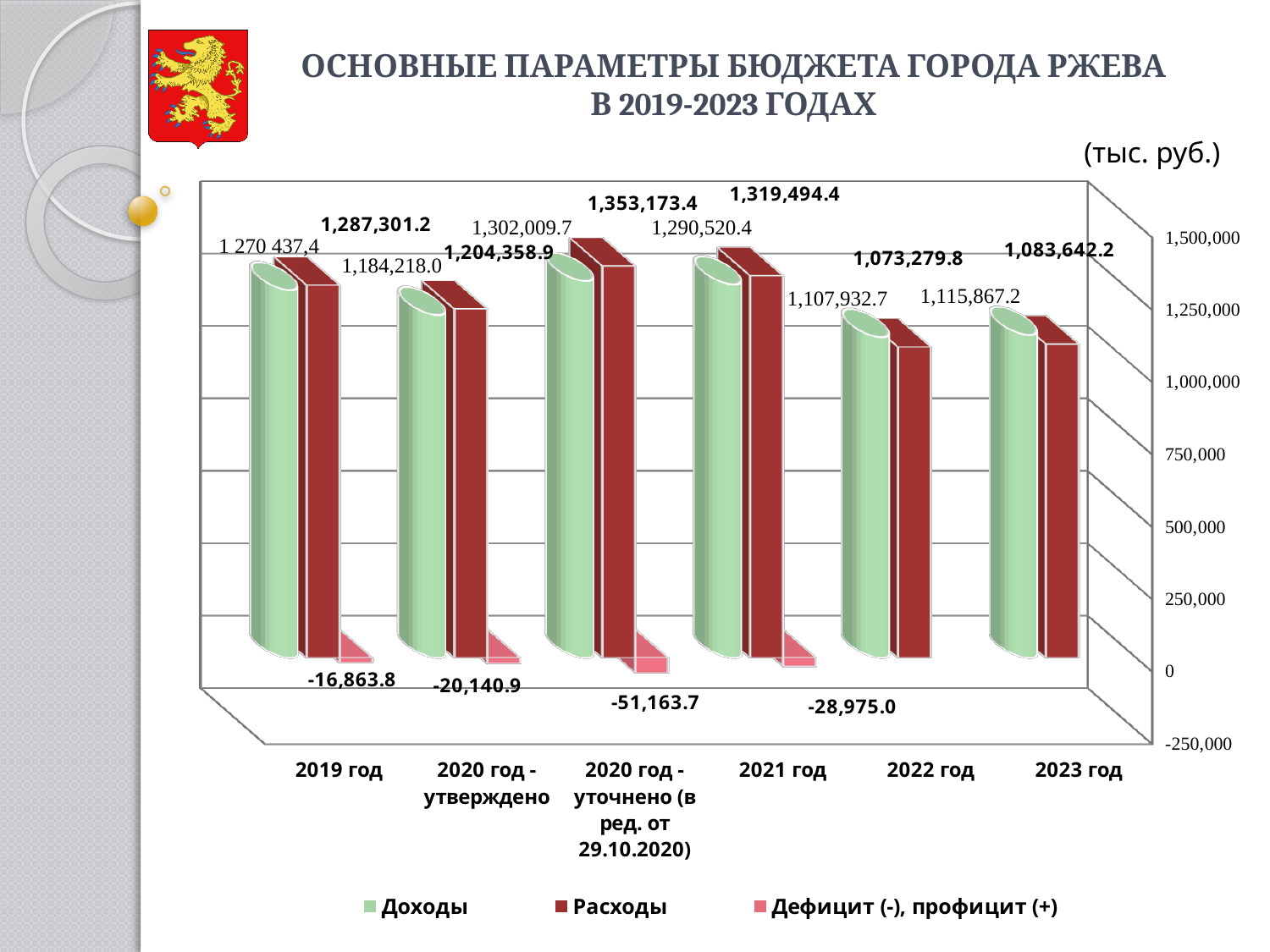
Which category has the lowest value of Доходы? 2022 год Which is larger for 2023 год, Доходы or Расходы? Доходы What is the value of Расходы for 2021 год? 1,319,494.4 How many series does the legend list? 3 What is the value of Расходы for 2023 год? 1,083,642.2 What is the difference between Расходы for 2020 год - утверждено and Расходы for 2019 год? 82,942.3 What type of chart is shown on the slide? bar chart What is the value of Доходы for 2022 год? 1,107,932.7 How many categories are shown on the x axis? 6 What unit is indicated above the chart? (тыс. руб.) What is the value of Дефицит (-), профицит (+) for 2020 год - уточнено (в ред. от 29.10.2020)? -51,163.7 Which category has the highest value of Расходы? 2020 год - уточнено (в ред. от 29.10.2020)